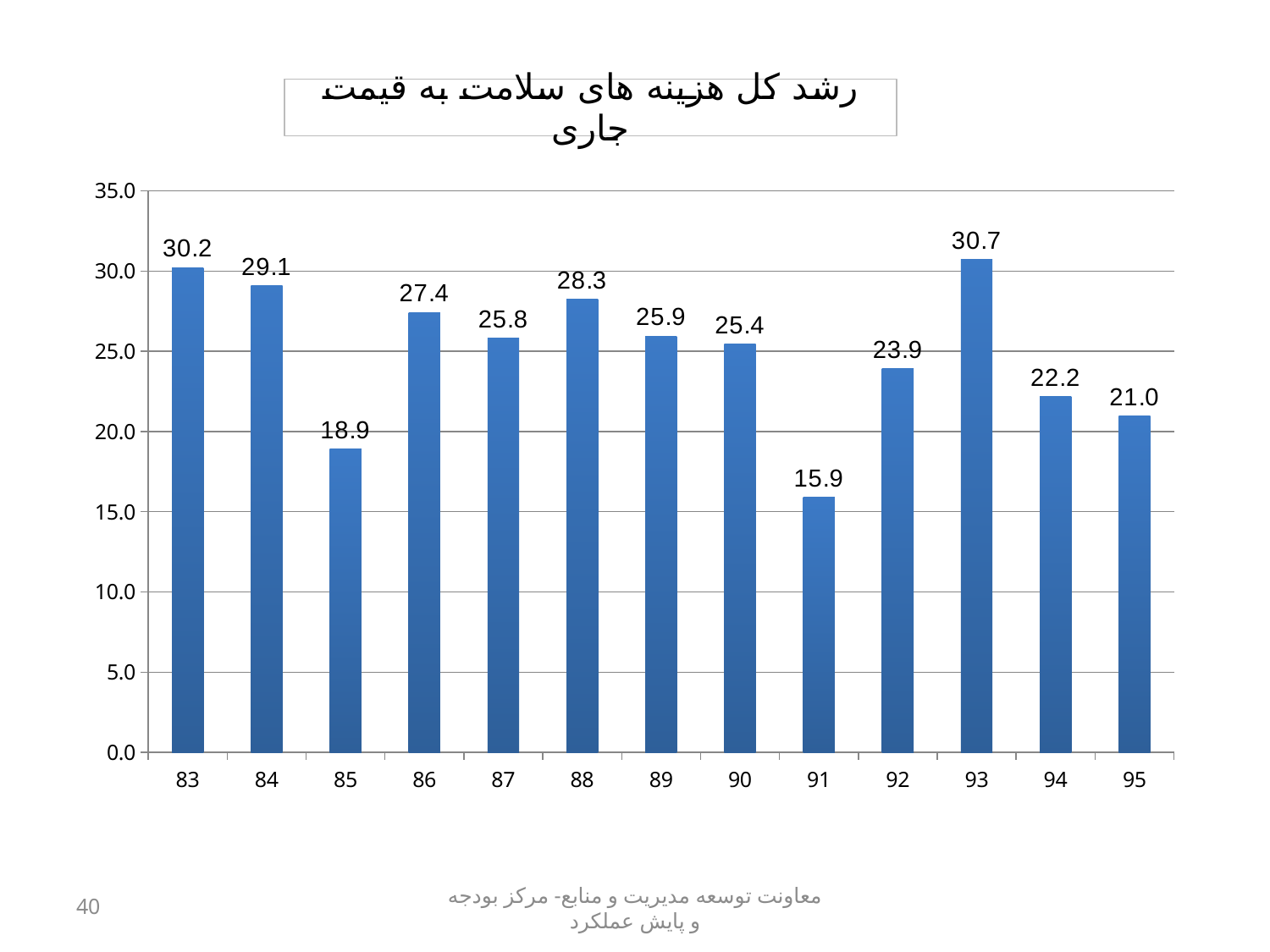
What is the value for 95? 21.0 Which year has the lowest value? 91 Is the value for 85 greater or less than 20.0? less What is the value for 83? 30.2 Do the values rise or fall from 93 to 95? fall What is the difference between the values for 83 and 84? 1.1 What is the value for 91? 15.9 How many bars are shown in the chart? 13 What is the difference between the values for 93 and 91? 14.8 Which is larger, the value for 86 or the value for 88? 88 Which year has the highest value? 93 What kind of chart is shown on the slide? bar chart